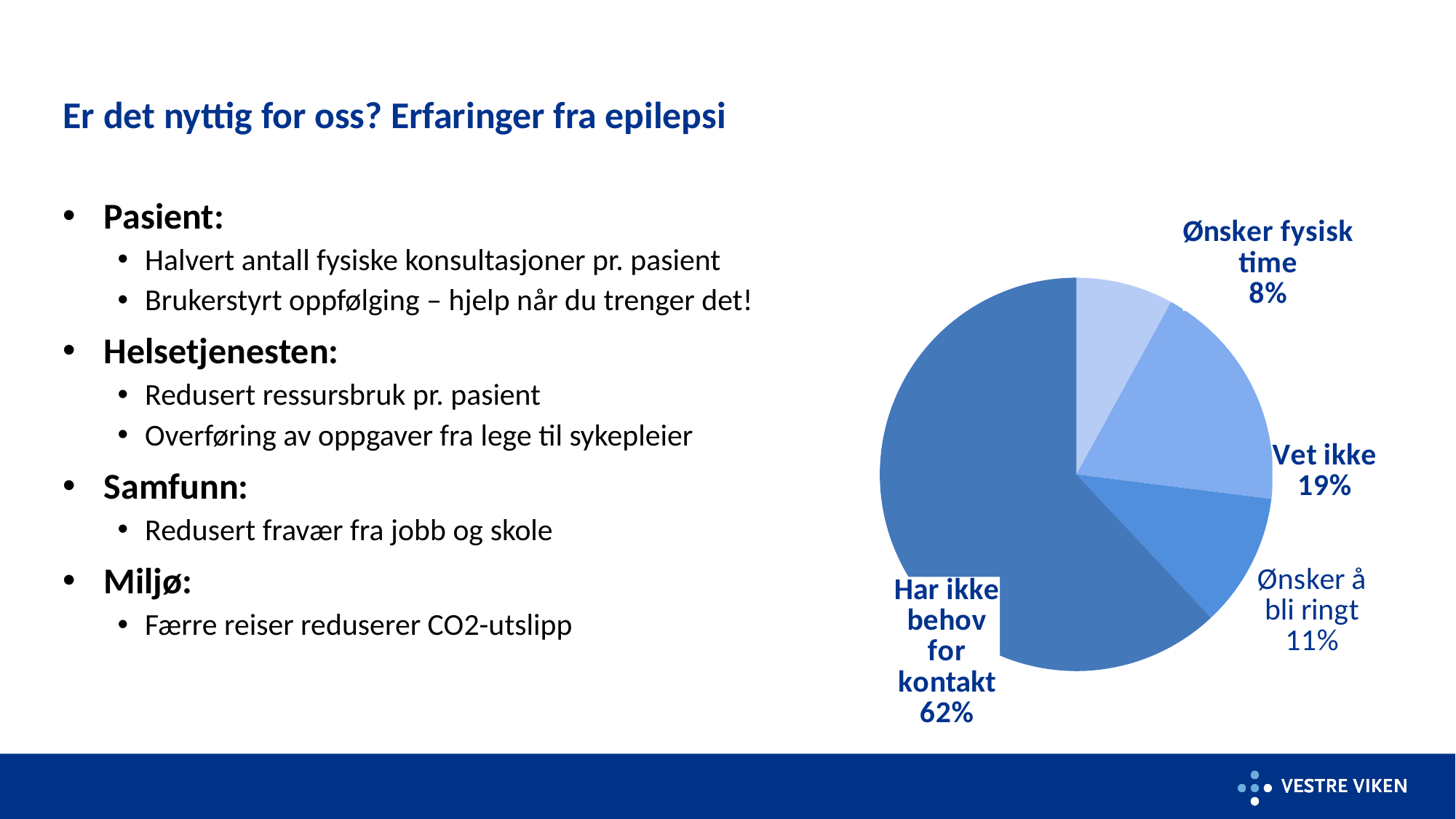
What kind of chart is shown on the slide? pie chart Which slice of the pie is the lightest shade of blue? Ønsker fysisk time What is the value shown for "Vet ikke"? 19% What is the value shown for "Ønsker å bli ringt"? 11% What is the difference in percentage points between "Vet ikke" and "Ønsker å bli ringt"? 8 Which is larger, "Vet ikke" or "Ønsker fysisk time"? Vet ikke How many slices does the pie chart have? 4 Which category has the smallest slice of the pie? Ønsker fysisk time What is the difference in percentage points between "Har ikke behov for kontakt" and "Vet ikke"? 43 What is the value shown for "Ønsker fysisk time"? 8% What share of the pie does "Har ikke behov for kontakt" represent? 62% Which category has the largest slice of the pie? Har ikke behov for kontakt